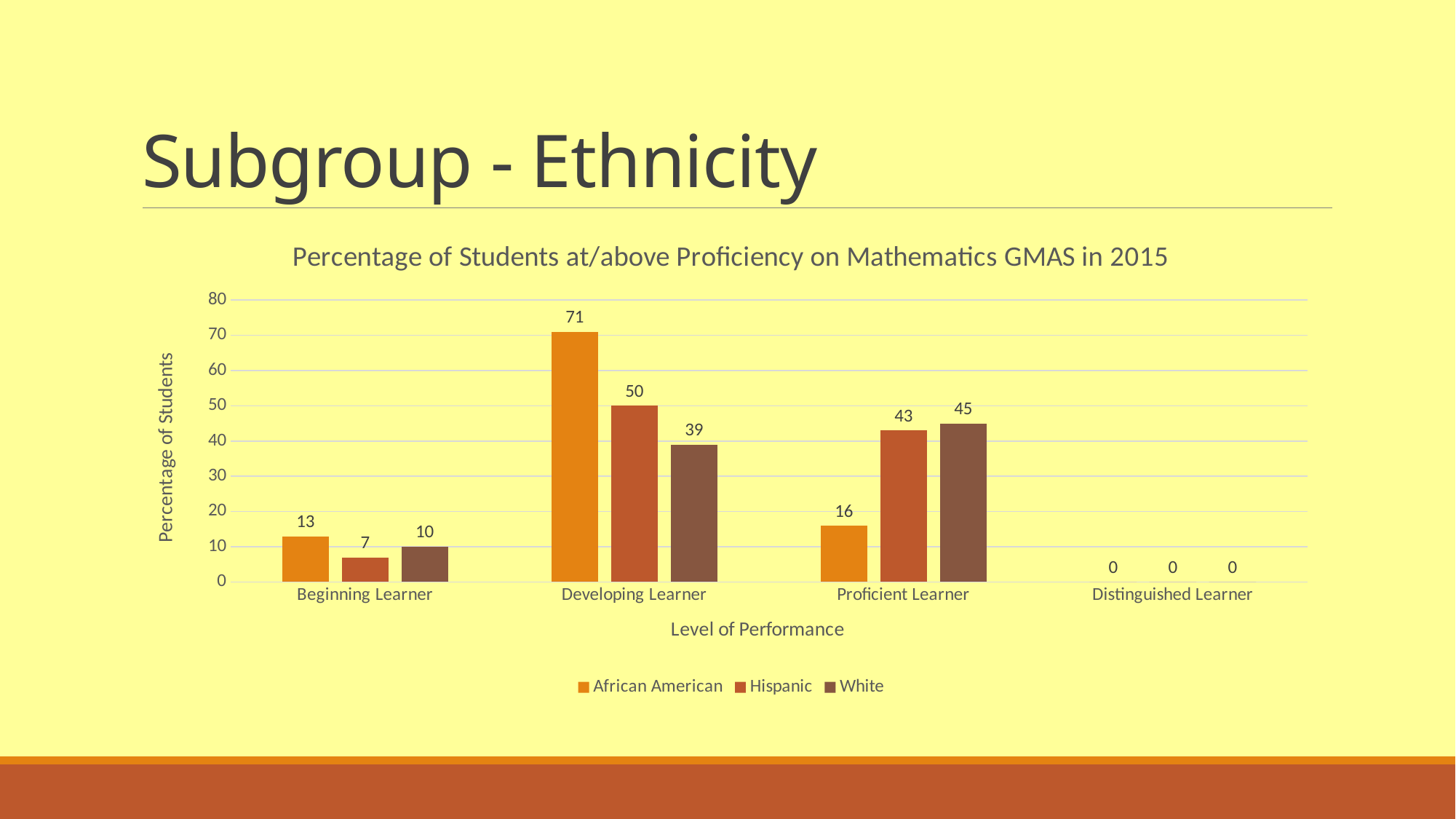
What is the value for Hispanic students at the Beginning Learner level? 7 How many performance levels are shown on the x axis? 4 What is the difference between the African American and White values at the Developing Learner level? 32 What is the title of the chart? Percentage of Students at/above Proficiency on Mathematics GMAS in 2015 How many series does the legend list? 3 What kind of chart is shown on the slide? Bar chart Which performance level has the highest value for African American students? Developing Learner Which ethnic group has the lowest value at the Developing Learner level? White Which is larger at the Proficient Learner level: the Hispanic value or the African American value? Hispanic What is the value for African American students at the Developing Learner level? 71 What is the value for White students at the Proficient Learner level? 45 Is the value for Hispanic students at the Developing Learner level greater or less than 40? greater